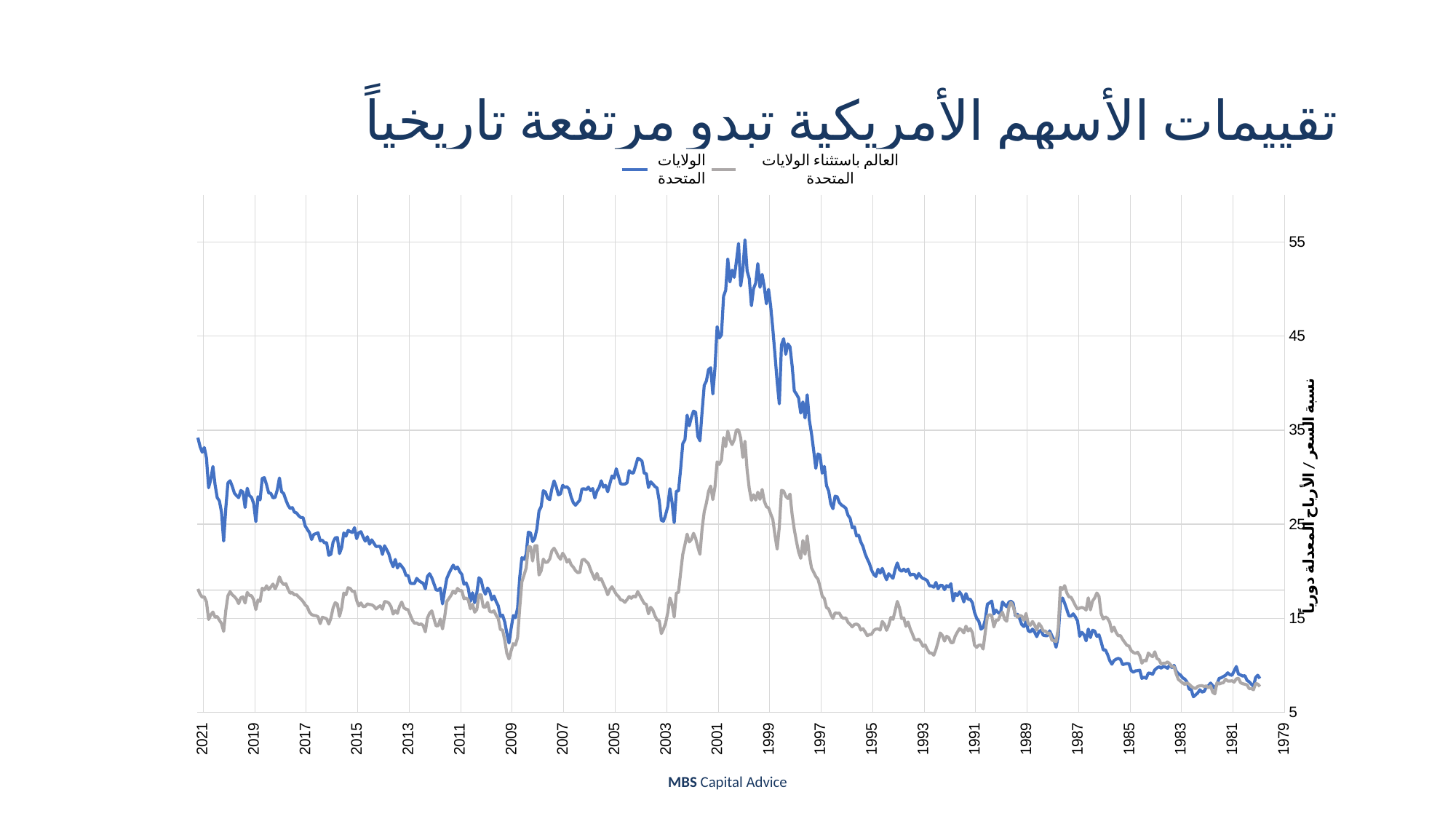
How many series does the legend list? 2 Moving along the x axis from 2021 toward 2009, does the الولايات المتحدة line generally rise or fall? fall What kind of chart is shown on the slide? line chart Which colour is used for the الولايات المتحدة series? blue At 2021, which series has the larger value, الولايات المتحدة or العالم باستثناء الولايات المتحدة? الولايات المتحدة Is the value of the العالم باستثناء الولايات المتحدة series at 2021 greater or less than 25? less Is the value of the الولايات المتحدة series at 1983 greater or less than 15? less Which series reaches the highest value on the chart? الولايات المتحدة What is the title of the chart? تقييمات الأسهم الأمريكية تبدو مرتفعة تاريخياً Is the value of the الولايات المتحدة series at 2021 greater or less than 25? greater